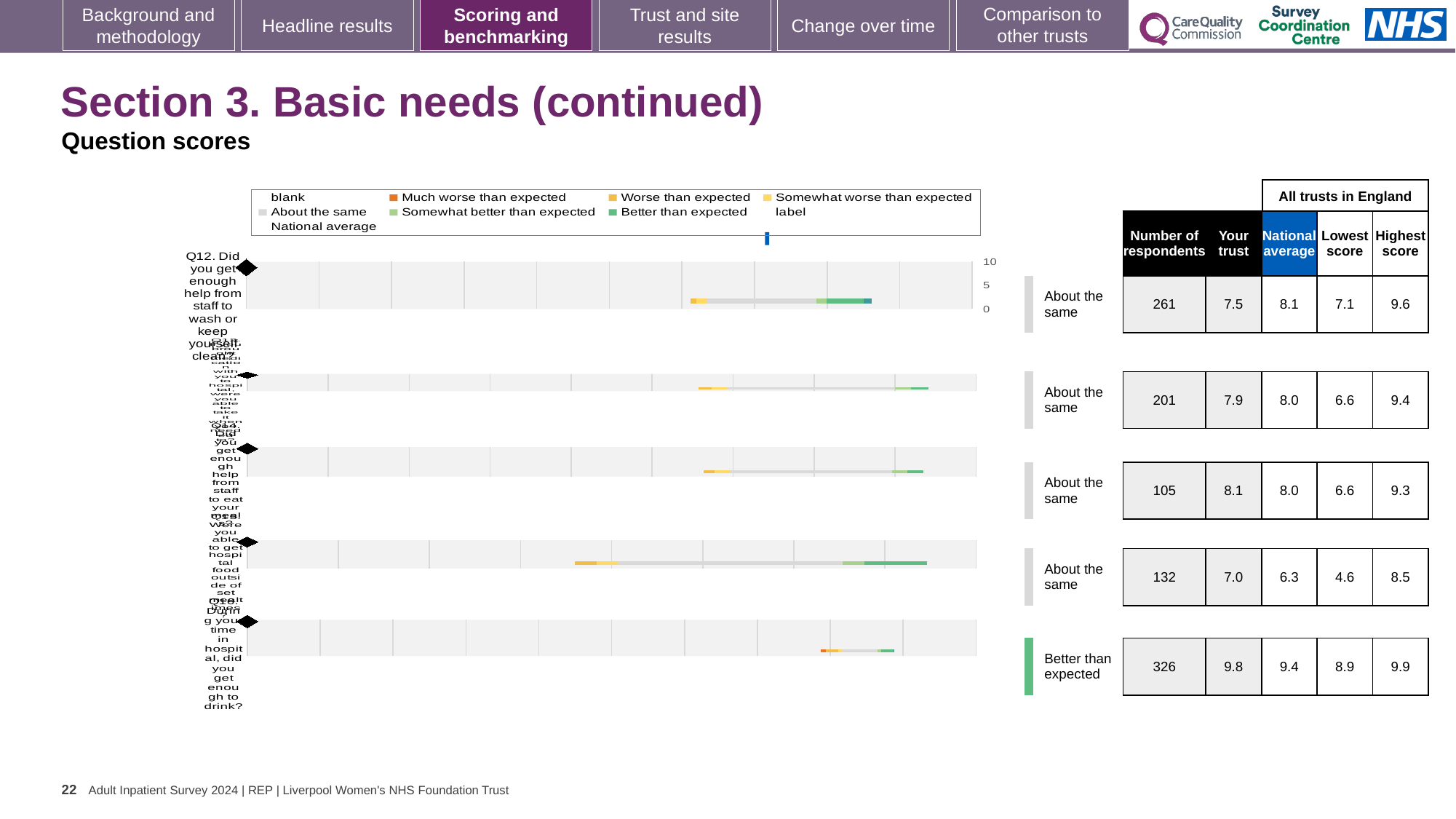
How many of the question rows are rated 'About the same'? 4 Which question row has the lowest 'Your trust' score? Q15 (hospital food outside of set meal times) Which question row has the highest 'Your trust' score? Q16 (did you get enough to drink) What kind of chart is used to show the question scores on this slide? bar chart What is the national average for the last row, Q16 (did you get enough to drink)? 9.4 What is the highest score across all trusts in England for Q14 (help from staff to eat your meals)? 9.3 For Q16 (did you get enough to drink), what is the difference between the 'Your trust' score and the national average? 0.4 What benchmark category is shown for the last row, Q16 (did you get enough to drink)? Better than expected How many question rows are plotted in the chart? 5 How many respondents are listed for Q16 (did you get enough to drink)? 326 For Q12 (help to wash or keep yourself clean), which is larger: the 'Your trust' score or the national average? National average What is the 'Your trust' score for the first row, Q12 (help from staff to wash or keep yourself clean)? 7.5